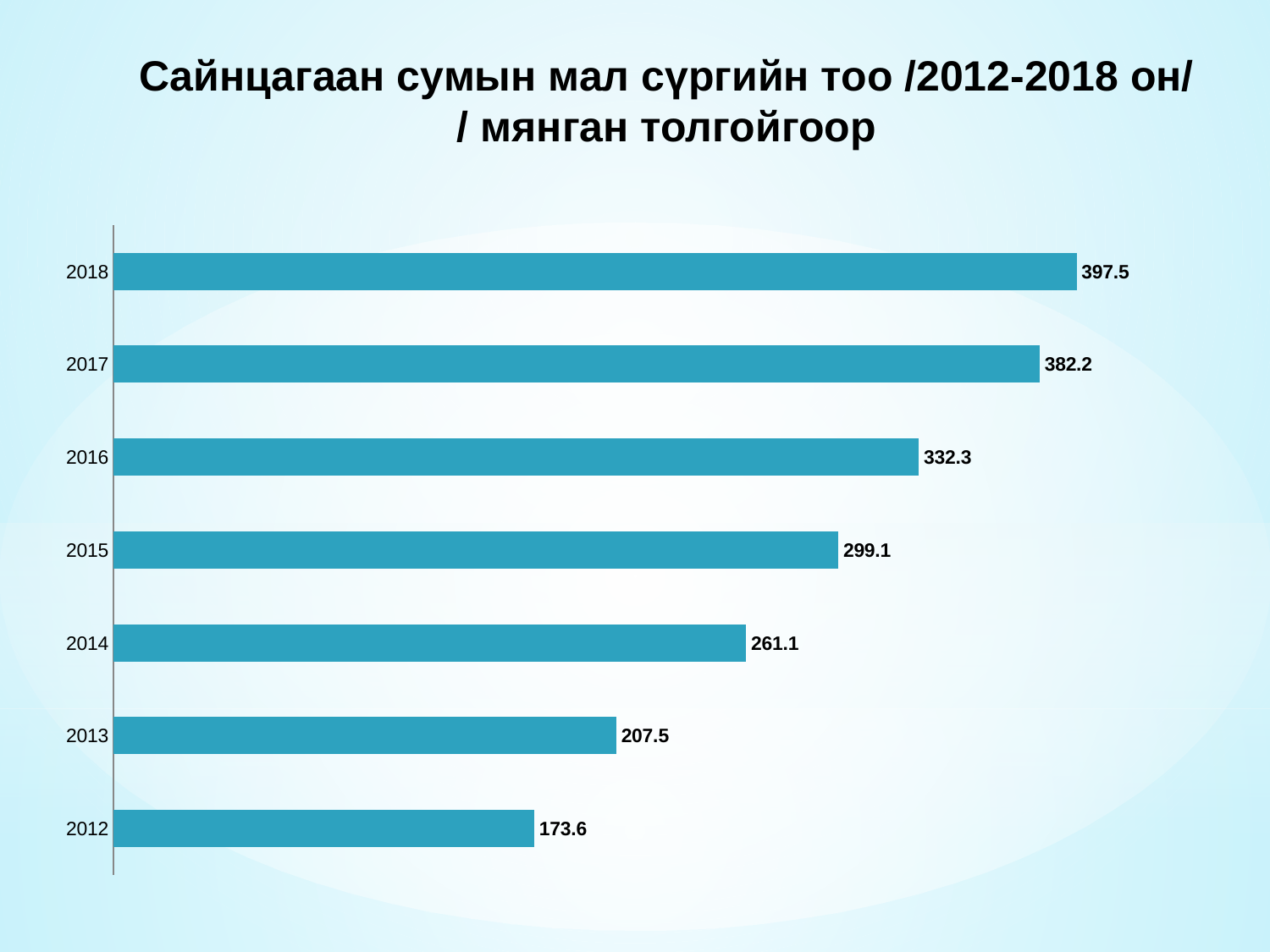
What is the difference between the values for 2018 and 2017? 15.3 Which year has the highest value? 2018 What is the difference between the values for 2013 and 2012? 33.9 What is the value for 2012? 173.6 How many years are shown in the chart? 7 What is the title of the chart? Сайнцагаан сумын мал сүргийн тоо /2012-2018 он/ / мянган толгойгоор What is the value for 2018? 397.5 What kind of chart is shown on the slide? Bar chart What is the value for 2015? 299.1 Which year has the lowest value? 2012 Do the values rise or fall from 2012 to 2018? Rise Which is larger, the value for 2016 or the value for 2014? 2016